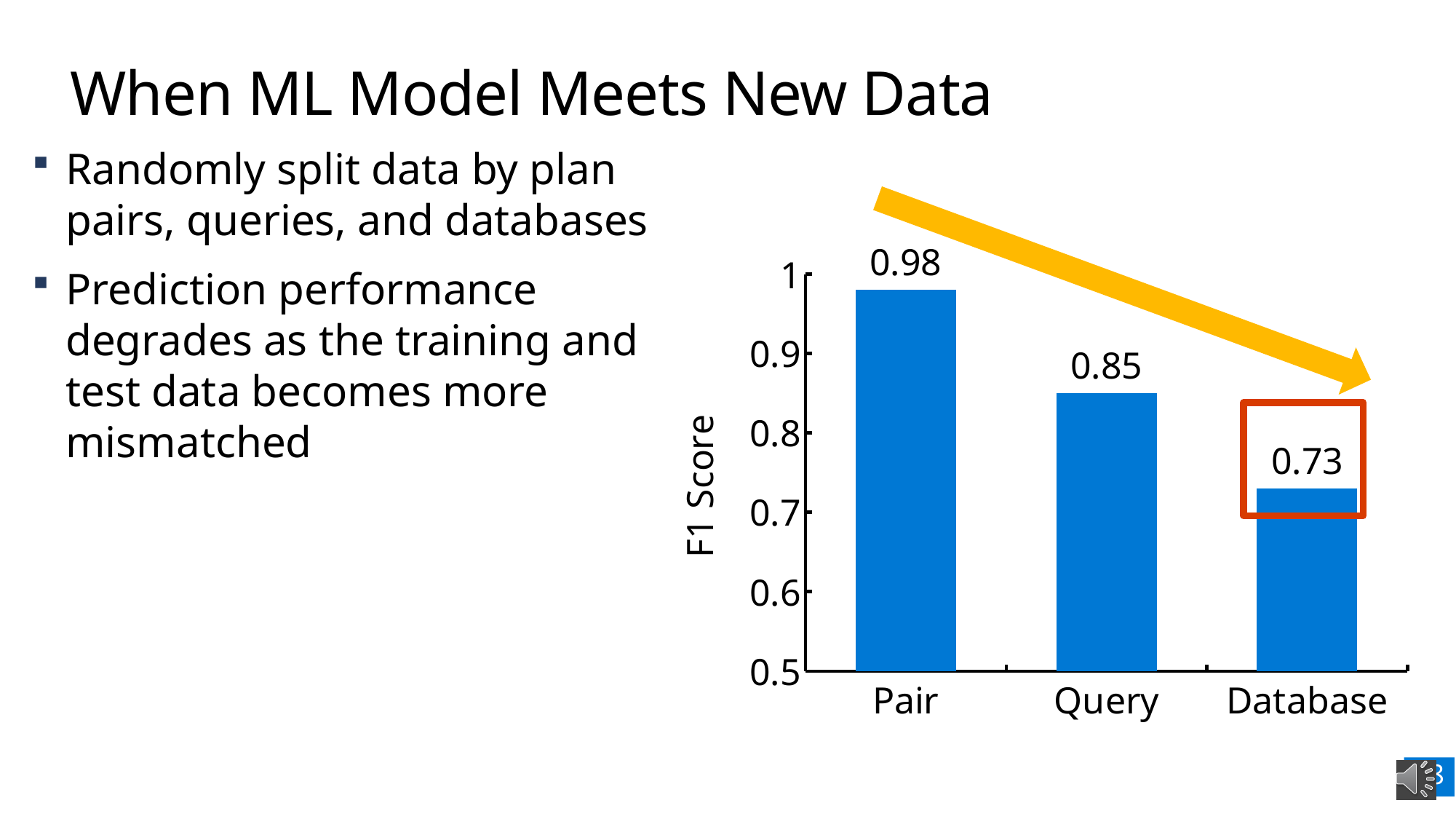
What is the difference between the F1 Score for Pair and the F1 Score for Database? 0.25 Is the F1 Score for Query greater or less than 0.8? greater What kind of chart is shown on the slide? bar chart Which category has the highest F1 Score? Pair What is the F1 Score for Query? 0.85 Do the F1 Score values rise or fall from Pair to Database? fall What is the difference between the F1 Score for Query and the F1 Score for Database? 0.12 What is the F1 Score for Pair? 0.98 How many categories are shown on the x axis? 3 Which category has the lowest F1 Score? Database What is the F1 Score for Database? 0.73 Which has a higher F1 Score, Query or Database? Query